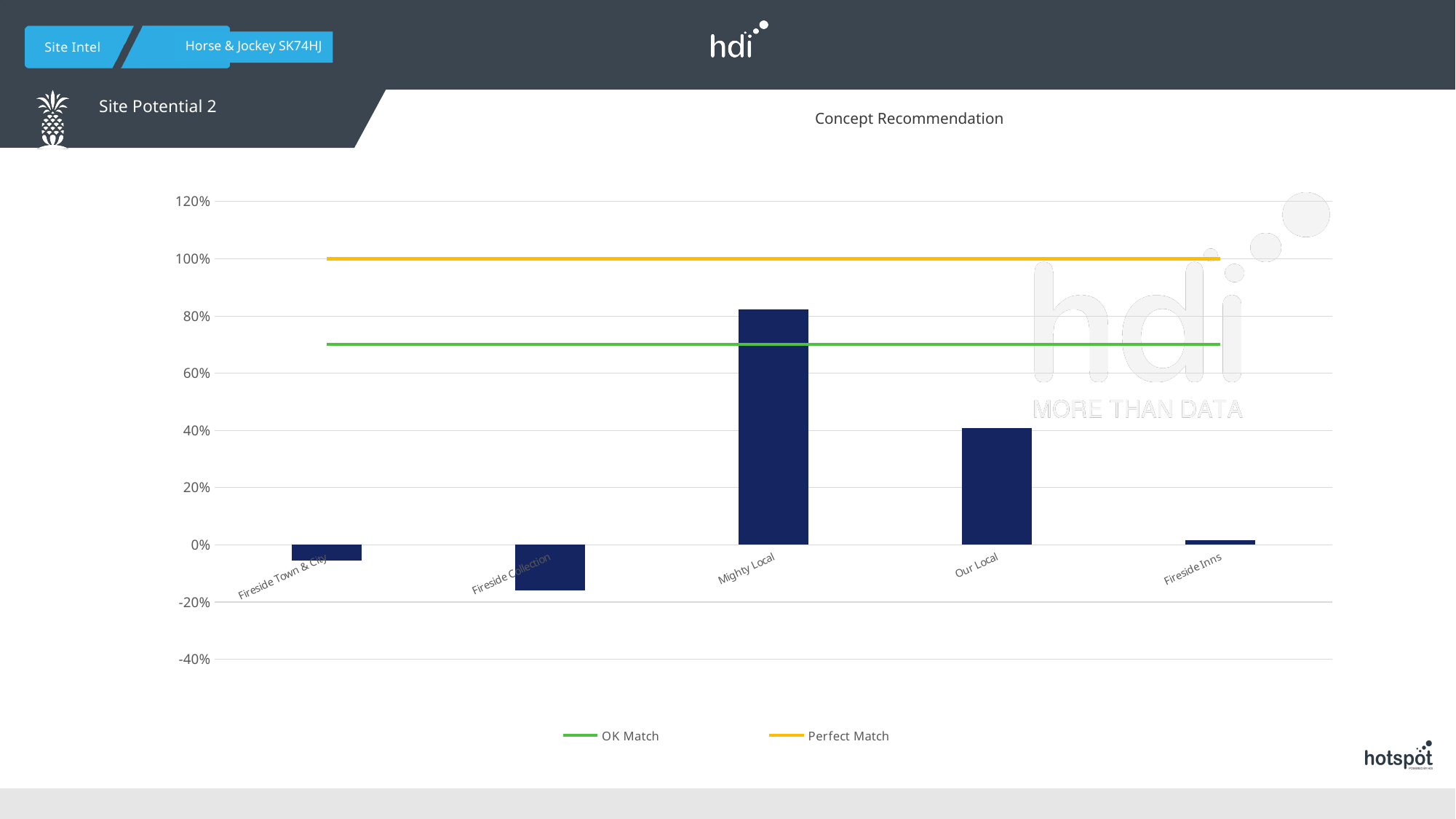
Which is larger, the value for Fireside Town & City or the value for Fireside Collection? Fireside Town & City How many concept categories are plotted along the x axis? 5 Is the value for Fireside Collection greater or less than 0%? less Which concept has the lowest bar? Fireside Collection What kind of chart is shown on the slide? bar chart Which is larger, the value for Mighty Local or the value for Our Local? Mighty Local Is the value for Our Local greater or less than 60%? less Is the value for Mighty Local greater or less than 60%? greater At what level is the Perfect Match line drawn? 100% Which concept has the highest bar? Mighty Local What is the title of the chart? Concept Recommendation How many entries does the legend list? 2